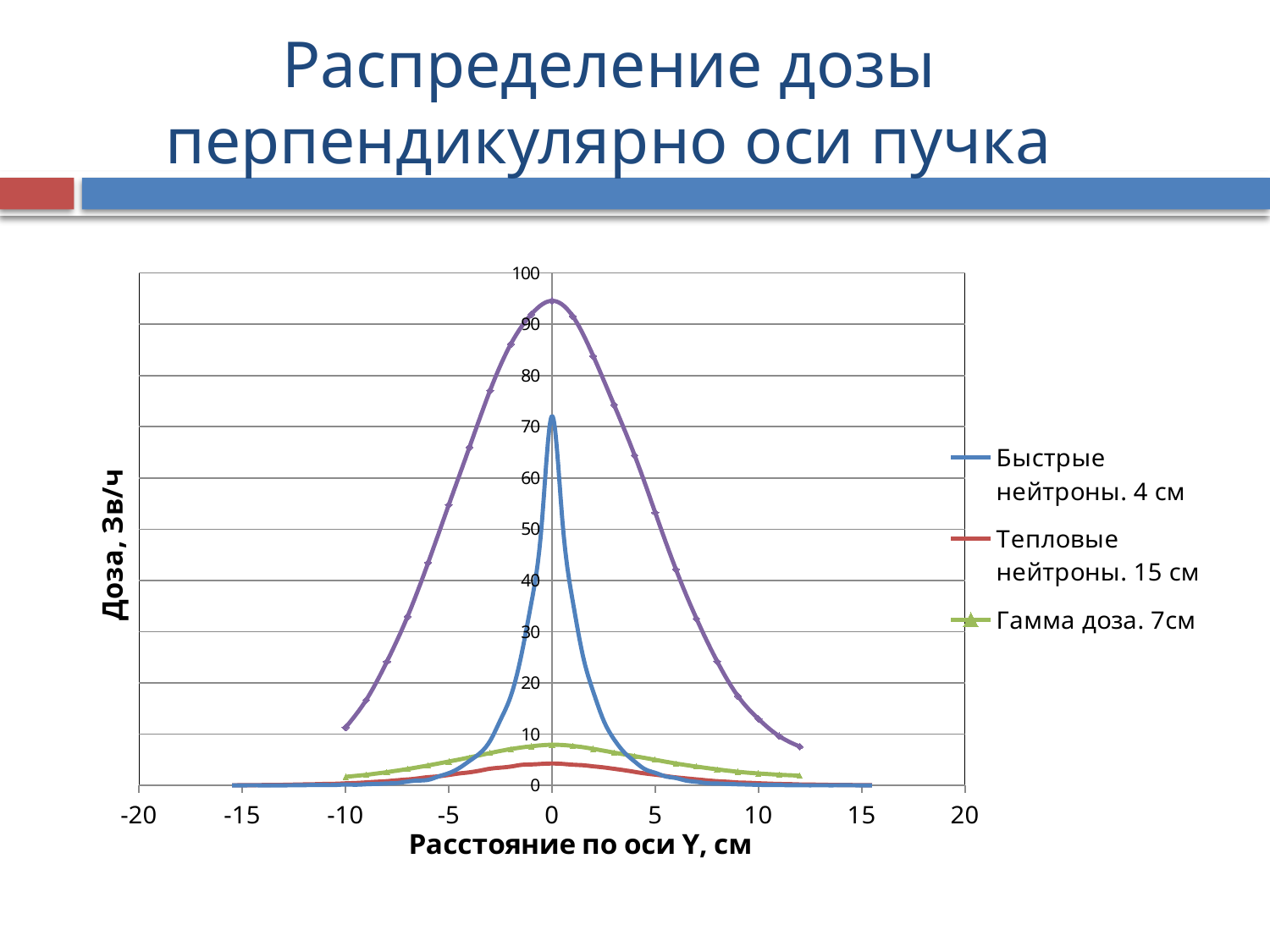
Is the peak value of the 'Тепловые нейтроны. 15 см' series at 0 cm greater or less than 10? less Among the three legend series, which has the highest peak value? Быстрые нейтроны. 4 см How many series does the legend list? 3 Is the peak value of the 'Гамма доза. 7см' series at 0 cm greater or less than 10? less Among the three legend series, which has the lowest peak value? Тепловые нейтроны. 15 см What kind of chart is shown on the slide? line chart At 0 cm, which series has the larger value: 'Быстрые нейтроны. 4 см' or 'Гамма доза. 7см'? Быстрые нейтроны. 4 см Does the 'Быстрые нейтроны. 4 см' series rise or fall as the distance goes from 0 cm to 5 cm? fall What is the label of the x axis? Расстояние по оси Y, см At 0 cm, which series has the larger value: 'Гамма доза. 7см' or 'Тепловые нейтроны. 15 см'? Гамма доза. 7см Is the peak value of the 'Быстрые нейтроны. 4 см' series at 0 cm greater or less than 60? greater What is the title of the slide's chart? Распределение дозы перпендикулярно оси пучка